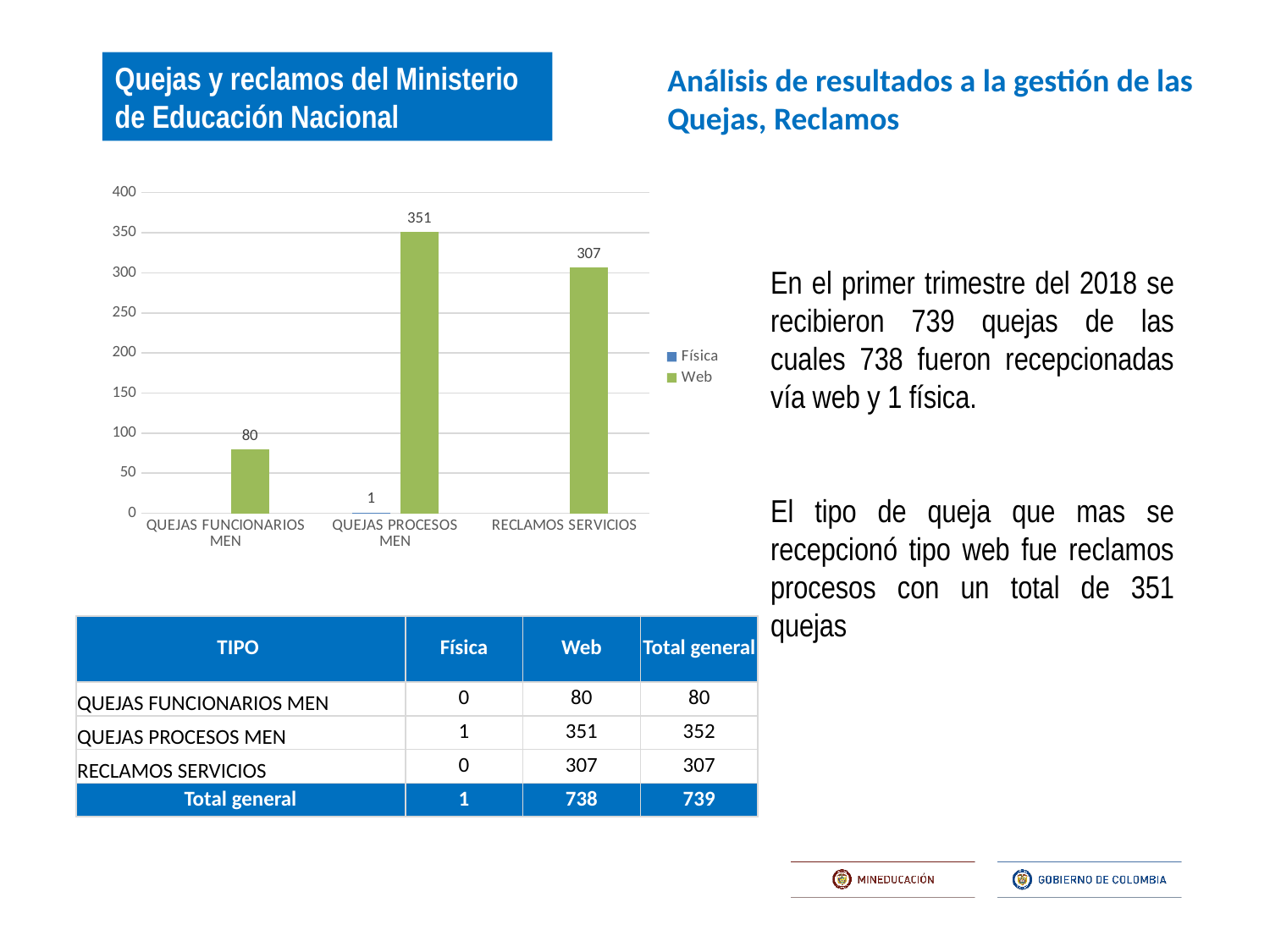
What is the Web value for RECLAMOS SERVICIOS? 307 Which is larger, the Web value for RECLAMOS SERVICIOS or for QUEJAS FUNCIONARIOS MEN? RECLAMOS SERVICIOS Which category has the lowest Web value? QUEJAS FUNCIONARIOS MEN How many categories are shown on the x axis of the chart? 3 How many series does the chart legend list? 2 Which category has the highest Web value? QUEJAS PROCESOS MEN What kind of chart is shown on the slide? bar chart Is the Web value for RECLAMOS SERVICIOS greater or less than 300? greater What is the Web value for QUEJAS FUNCIONARIOS MEN? 80 What is the difference between the Web values for QUEJAS PROCESOS MEN and RECLAMOS SERVICIOS? 44 What is the Física value for QUEJAS PROCESOS MEN? 1 What is the Web value for QUEJAS PROCESOS MEN? 351